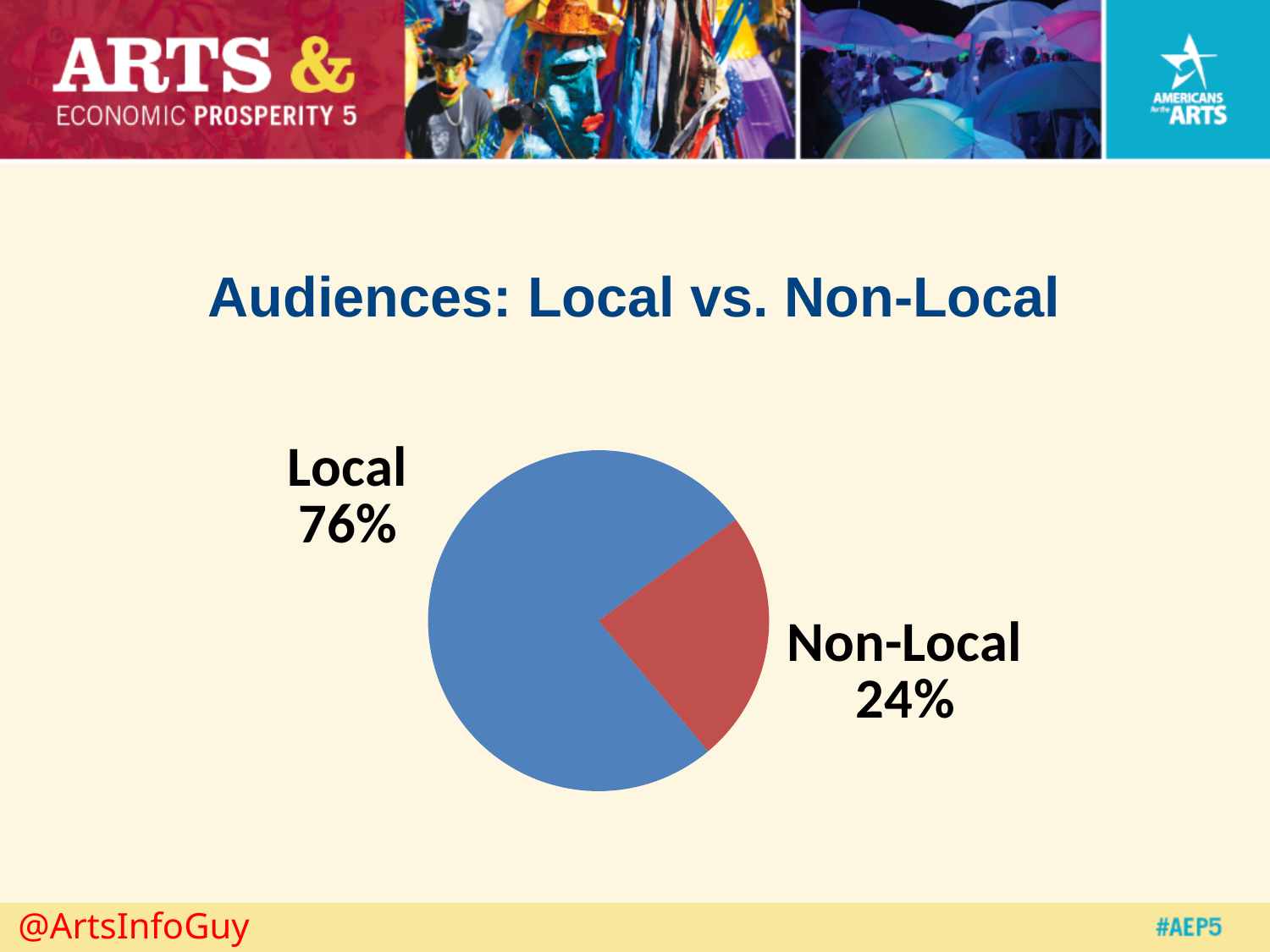
What is the title of the slide's chart? Audiences: Local vs. Non-Local Which slice of the pie is the smallest? Non-Local What share of audiences is Non-Local? 24% How many slices does the pie chart have? 2 What share of audiences is Local? 76% What kind of chart is shown on the slide? Pie chart What is the difference in percentage points between the Local and Non-Local shares? 52 Which is larger, the Local share or the Non-Local share? Local What colour is the Non-Local slice? Red What share of the pie does the blue slice represent? 76% Which slice of the pie is the largest? Local